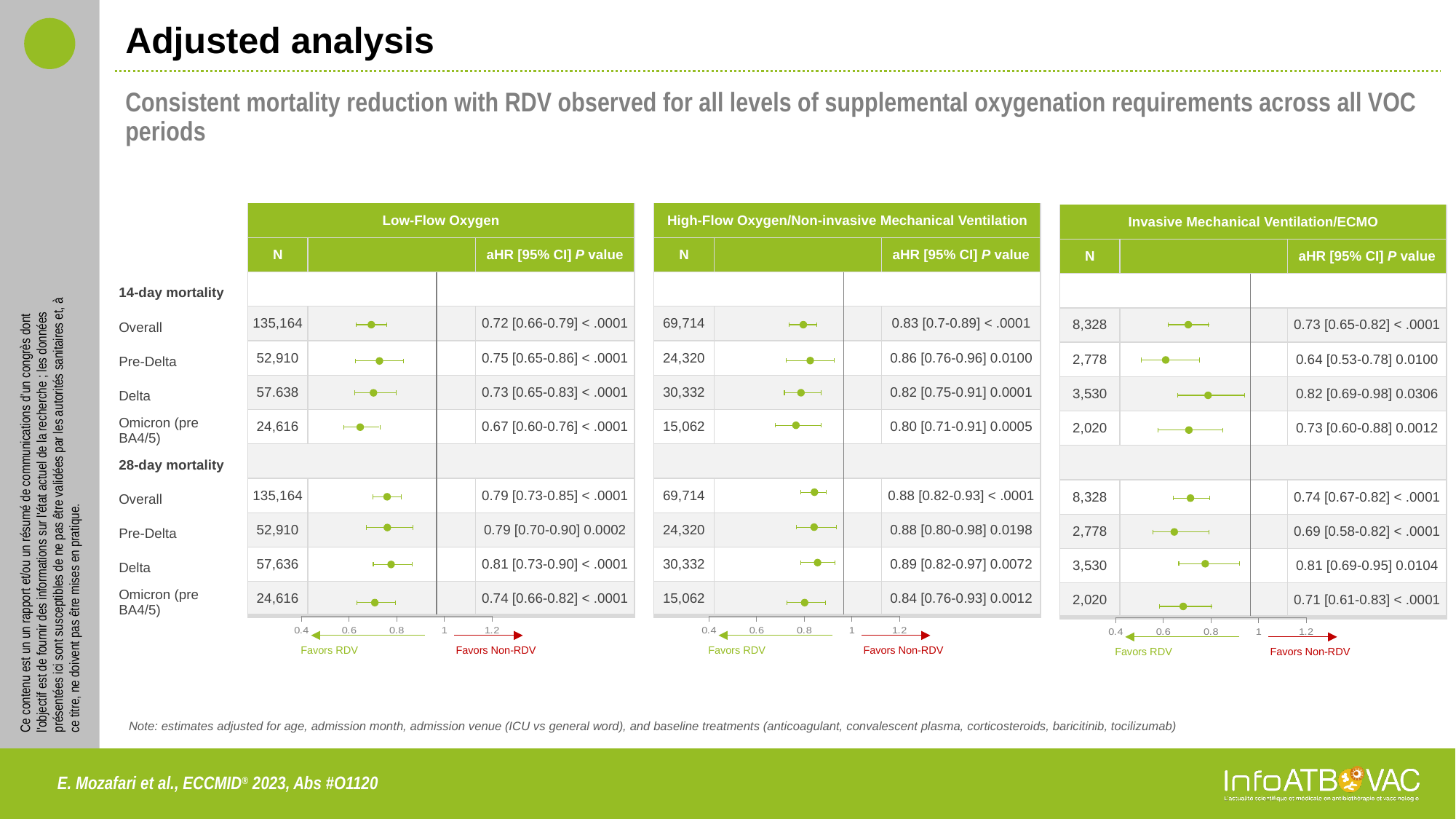
How many VOC period rows are plotted under 14-day mortality in the Invasive Mechanical Ventilation/ECMO chart? 4 What kind of chart is used in each of the three panels on the slide? forest plot In the High-Flow Oxygen/Non-invasive Mechanical Ventilation chart, what is the N for the Delta period? 30,332 In the High-Flow Oxygen/Non-invasive Mechanical Ventilation chart, which VOC period has the highest 28-day mortality aHR point estimate? Delta In the Low-Flow Oxygen chart, what is the difference between the 28-day and 14-day mortality aHR point estimates for Overall? 0.07 In the Low-Flow Oxygen chart, is the 14-day mortality aHR point estimate for Omicron (pre BA4/5) greater or less than 1? less In the Invasive Mechanical Ventilation/ECMO chart, what is the aHR [95% CI] for 28-day mortality, Pre-Delta? 0.69 [0.58-0.82] What is the title of the rightmost chart on the slide? Invasive Mechanical Ventilation/ECMO In the Low-Flow Oxygen chart, what does the left-pointing arrow below the axis indicate? Favors RDV In the High-Flow Oxygen/Non-invasive Mechanical Ventilation chart, which has the larger 14-day mortality aHR point estimate: Pre-Delta or Delta? Pre-Delta In the Invasive Mechanical Ventilation/ECMO chart, which VOC period has the lowest 14-day mortality aHR point estimate? Pre-Delta In the Low-Flow Oxygen chart, what is the aHR [95% CI] for 14-day mortality, Overall? 0.72 [0.66-0.79]